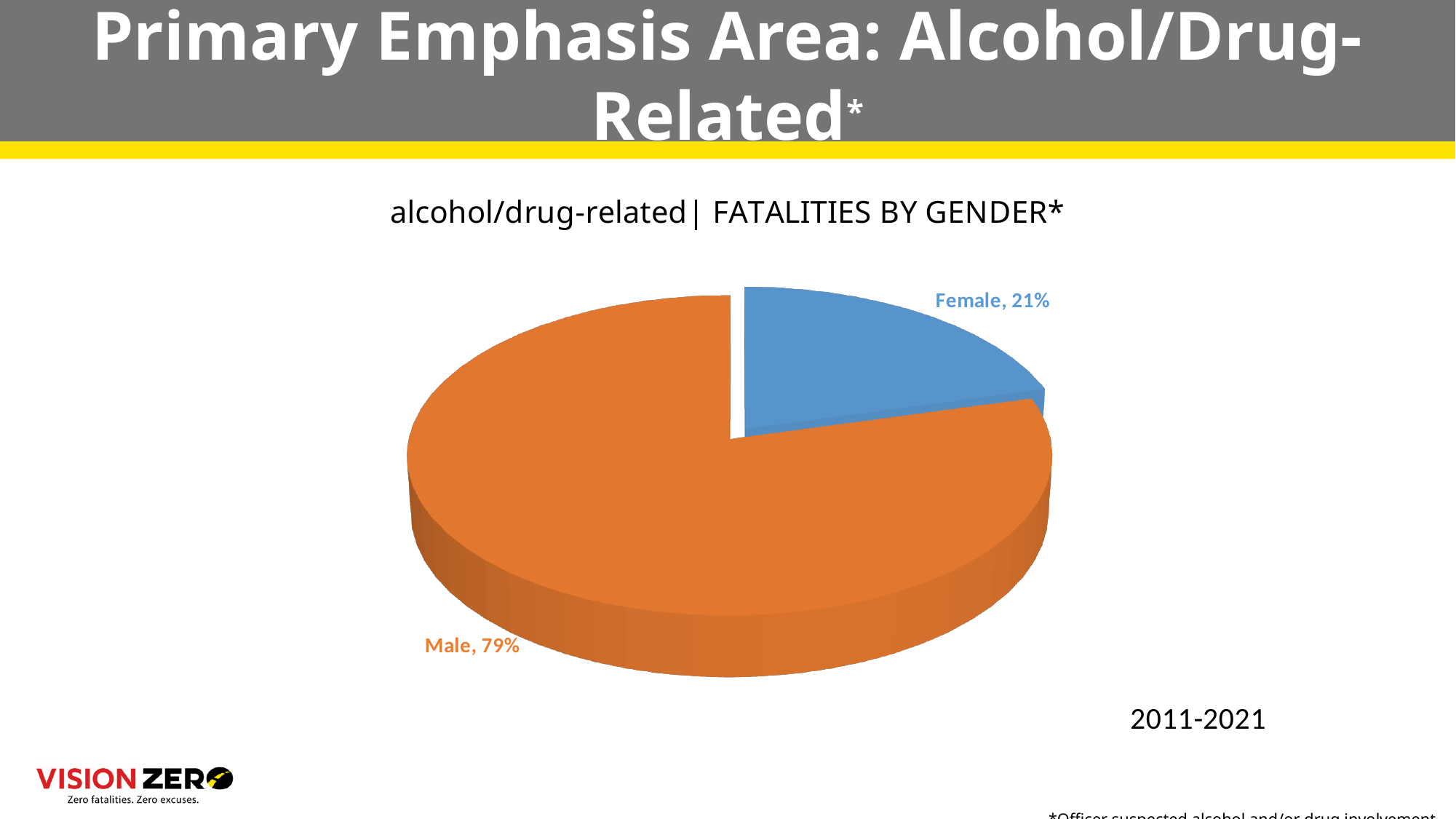
What share of alcohol/drug-related fatalities were male? 79% Which gender has the largest share of alcohol/drug-related fatalities? Male What share of alcohol/drug-related fatalities were female? 21% What is the title of the chart? alcohol/drug-related| FATALITIES BY GENDER* Which is larger, the male share or the female share? Male What kind of chart is shown on the slide? Pie chart What colour is the Female slice? Blue Which gender has the smallest share of alcohol/drug-related fatalities? Female What time period does the chart cover? 2011-2021 What is the difference in percentage points between the male and female shares? 58 How many slices does the pie chart have? 2